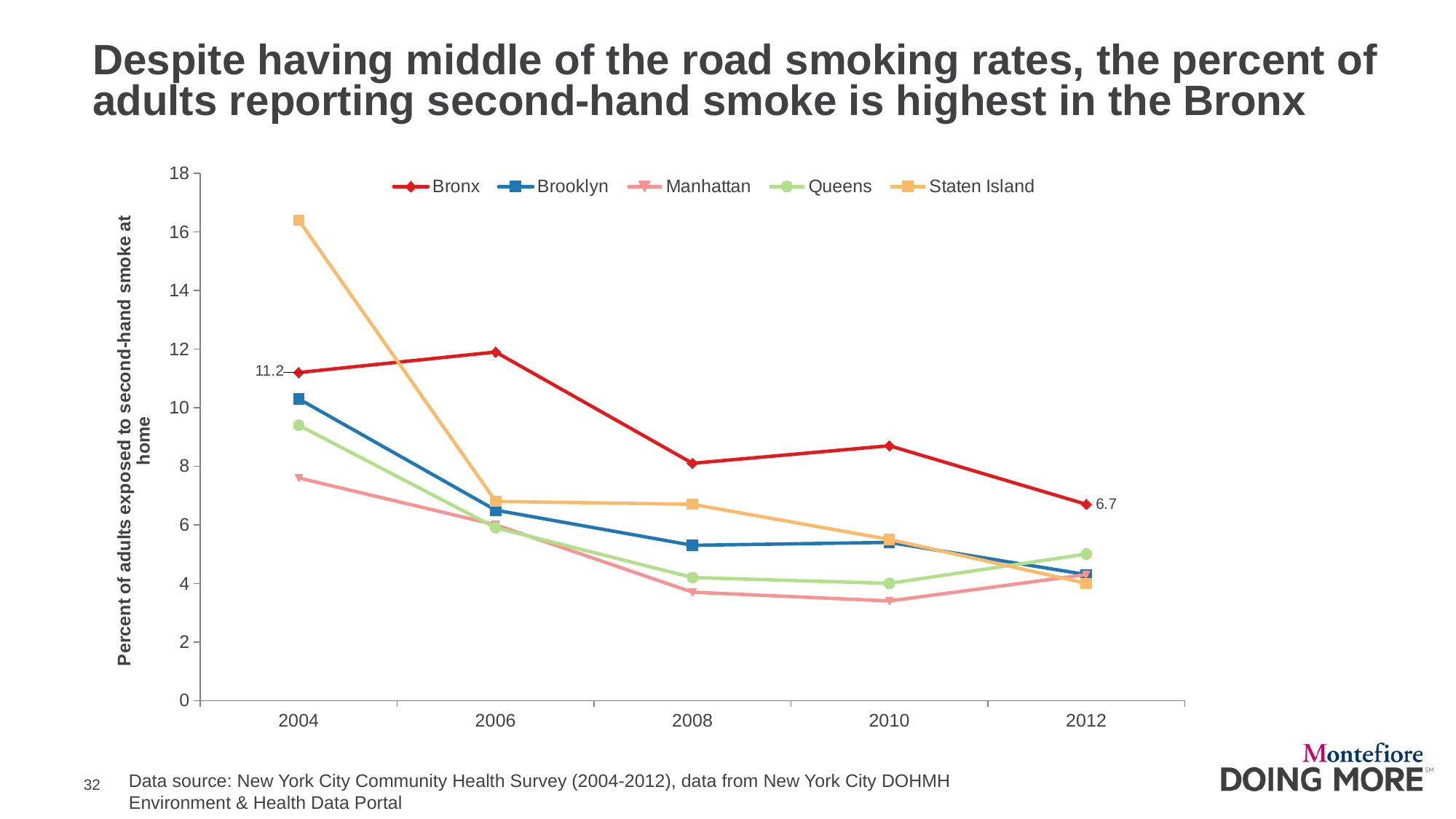
What kind of chart is shown on the slide? Line chart Which borough has the highest value in 2004? Staten Island Does the Bronx line rise or fall overall from 2004 to 2012? Fall Is the value for Staten Island in 2004 greater or less than 14? greater Which borough has the lowest value in 2004? Manhattan How many years are shown on the x axis? 5 By how much did the Bronx value fall from 2004 to 2012? 4.5 What is the value for the Bronx in 2012? 6.7 How many series does the legend list? 5 What is the title of the y axis? Percent of adults exposed to second-hand smoke at home What is the value for the Bronx in 2004? 11.2 In 2008, which is larger: the value for the Bronx or for Brooklyn? Bronx